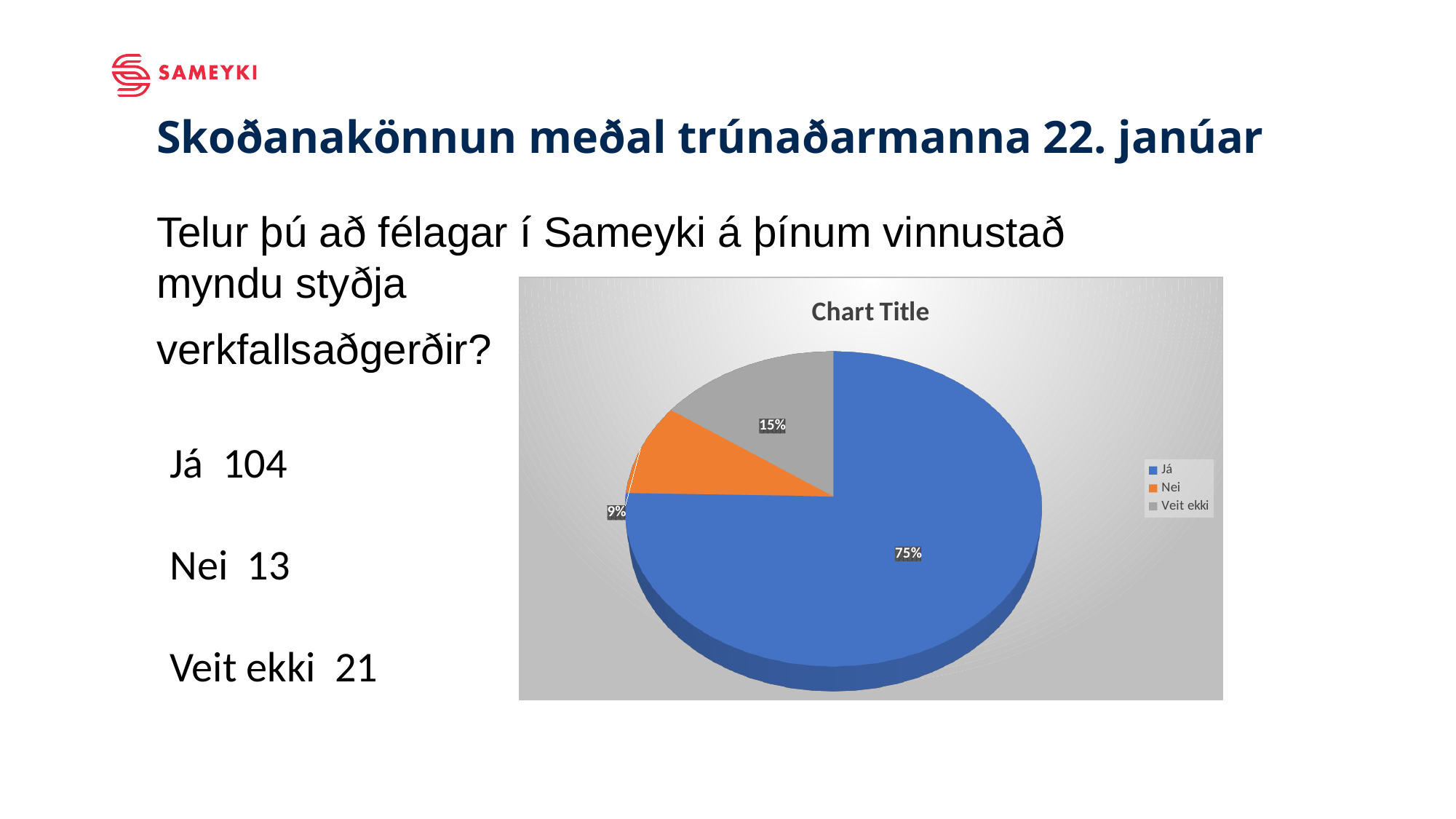
What percentage of the pie does the "Nei" slice represent? 9% How many entries does the chart legend list? 3 Which slice of the pie chart is the smallest? Nei What percentage of the pie does the "Já" slice represent? 75% Which slice of the pie chart is the largest? Já What percentage of the pie does the "Veit ekki" slice represent? 15% What kind of chart is shown on the slide? Pie chart What is the title shown on the chart? Chart Title What colour is the "Nei" slice in the pie chart? Orange What is the difference in percentage points between the "Já" slice and the "Veit ekki" slice? 60 Which is larger in the pie chart, the "Veit ekki" slice or the "Nei" slice? Veit ekki How many slices does the pie chart have? 3